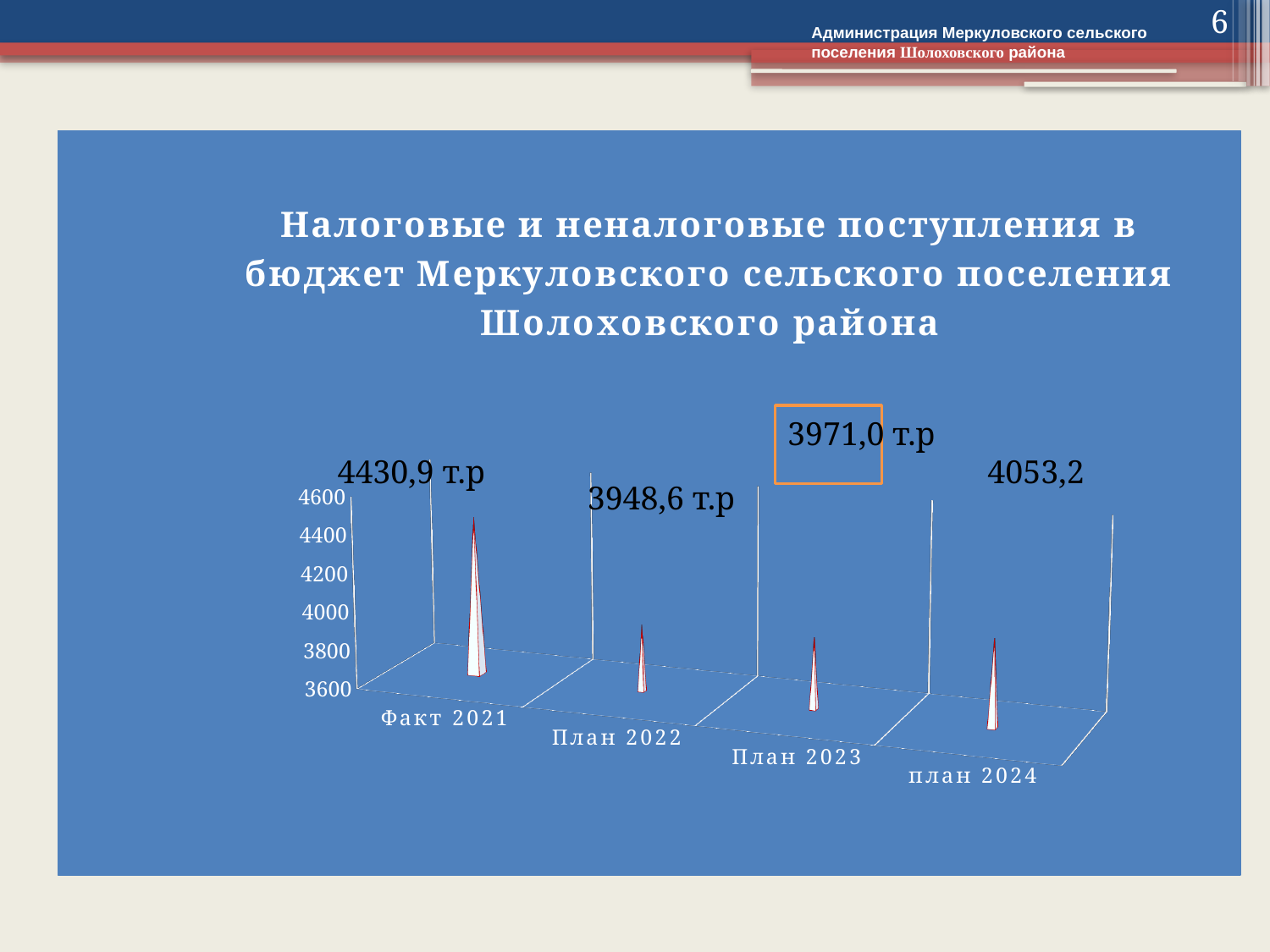
What is the value for План 2022? 3948,6 т.р What is the value for Факт 2021? 4430,9 т.р How many categories are shown on the x axis? 4 Is the value for План 2022 greater or less than 4000? less Do the values rise or fall from План 2022 to план 2024? rise What is the difference between the values for план 2024 and План 2023? 82,2 What is the difference between the values for Факт 2021 and План 2022? 482,3 Which category has the lowest value? План 2022 What is the value for План 2023? 3971,0 т.р Which category has the highest value? Факт 2021 What is the value for план 2024? 4053,2 Which is larger, the value for План 2023 or the value for план 2024? план 2024